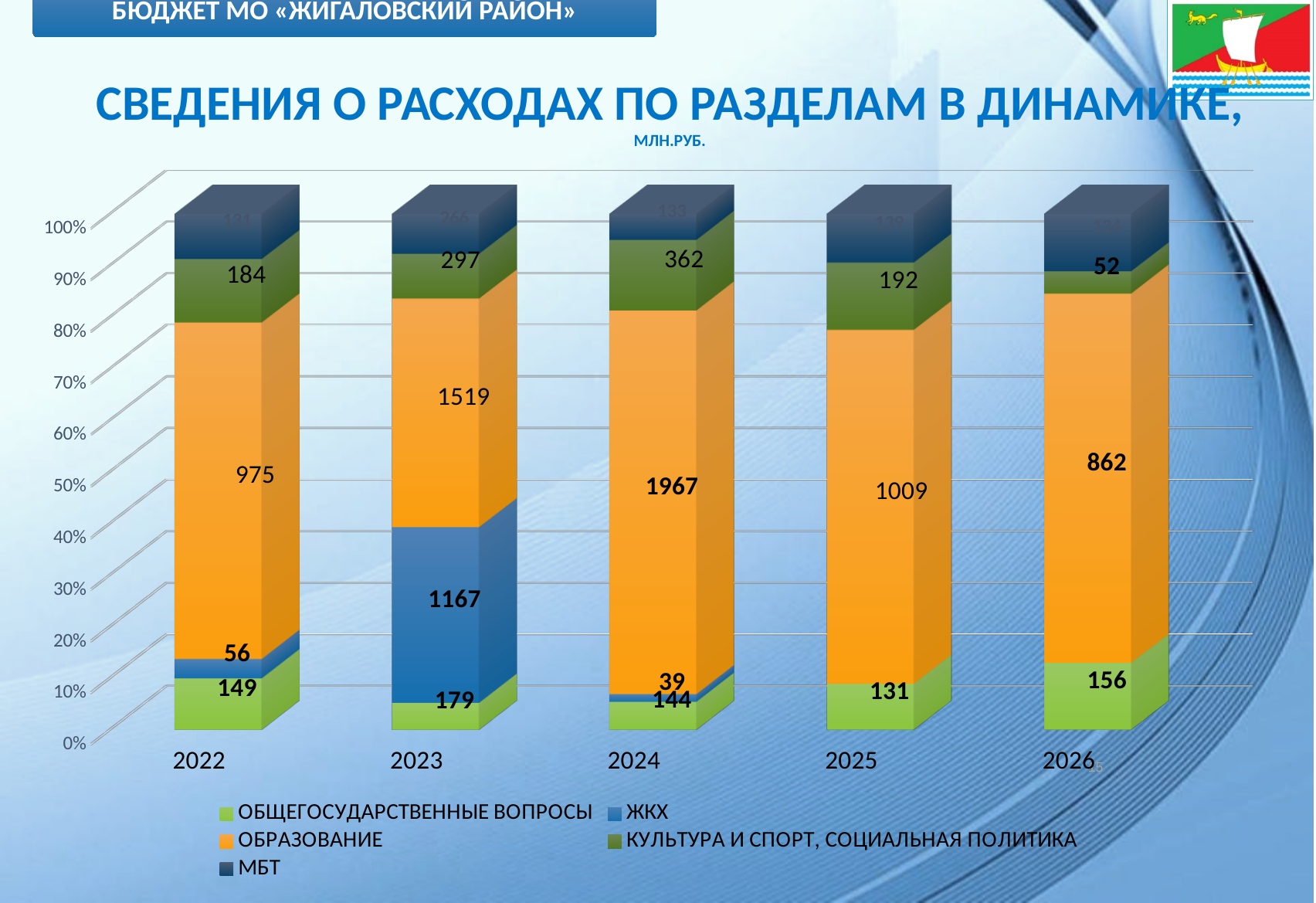
What is the value for ОБЩЕГОСУДАРСТВЕННЫЕ ВОПРОСЫ in 2022? 149 What is the value for ЖКХ in 2023? 1167 What is the value for ОБРАЗОВАНИЕ in 2024? 1967 In which year is the value for ОБРАЗОВАНИЕ the highest? 2024 In which year is the value for ОБЩЕГОСУДАРСТВЕННЫЕ ВОПРОСЫ the lowest? 2025 How many series does the legend list? 5 Which year has the larger ЖКХ value, 2022 or 2024? 2022 What colour represents ОБРАЗОВАНИЕ in the chart? orange How many years are shown along the x axis of the chart? 5 What is the value for КУЛЬТУРА И СПОРТ, СОЦИАЛЬНАЯ ПОЛИТИКА in 2024? 362 What kind of chart is shown on the slide? stacked bar chart What is the difference between the ОБРАЗОВАНИЕ values for 2023 and 2022? 544